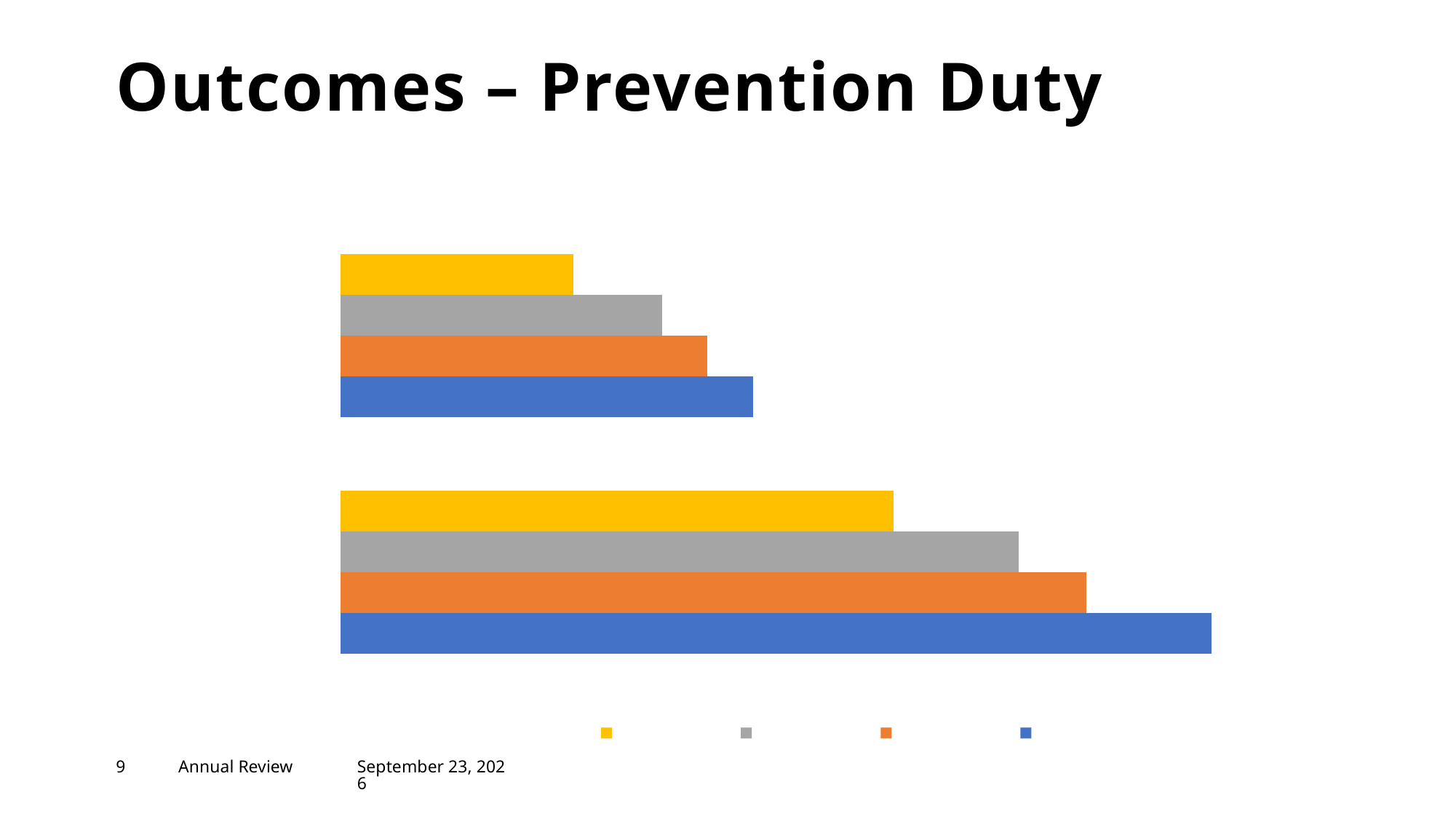
Is the longest bar in the upper group longer or shorter than the longest bar in the lower group? shorter How many bars are plotted in total in the chart? 8 Does the chart's legend show any readable text labels next to its colour markers? No How many series does the legend list? 4 What kind of chart is shown on the slide? bar chart How many groups of bars are plotted in the chart? 2 Which group of bars has the longer bars overall, the upper group or the lower group? the lower group Are the bars in the chart drawn horizontally or vertically? horizontally